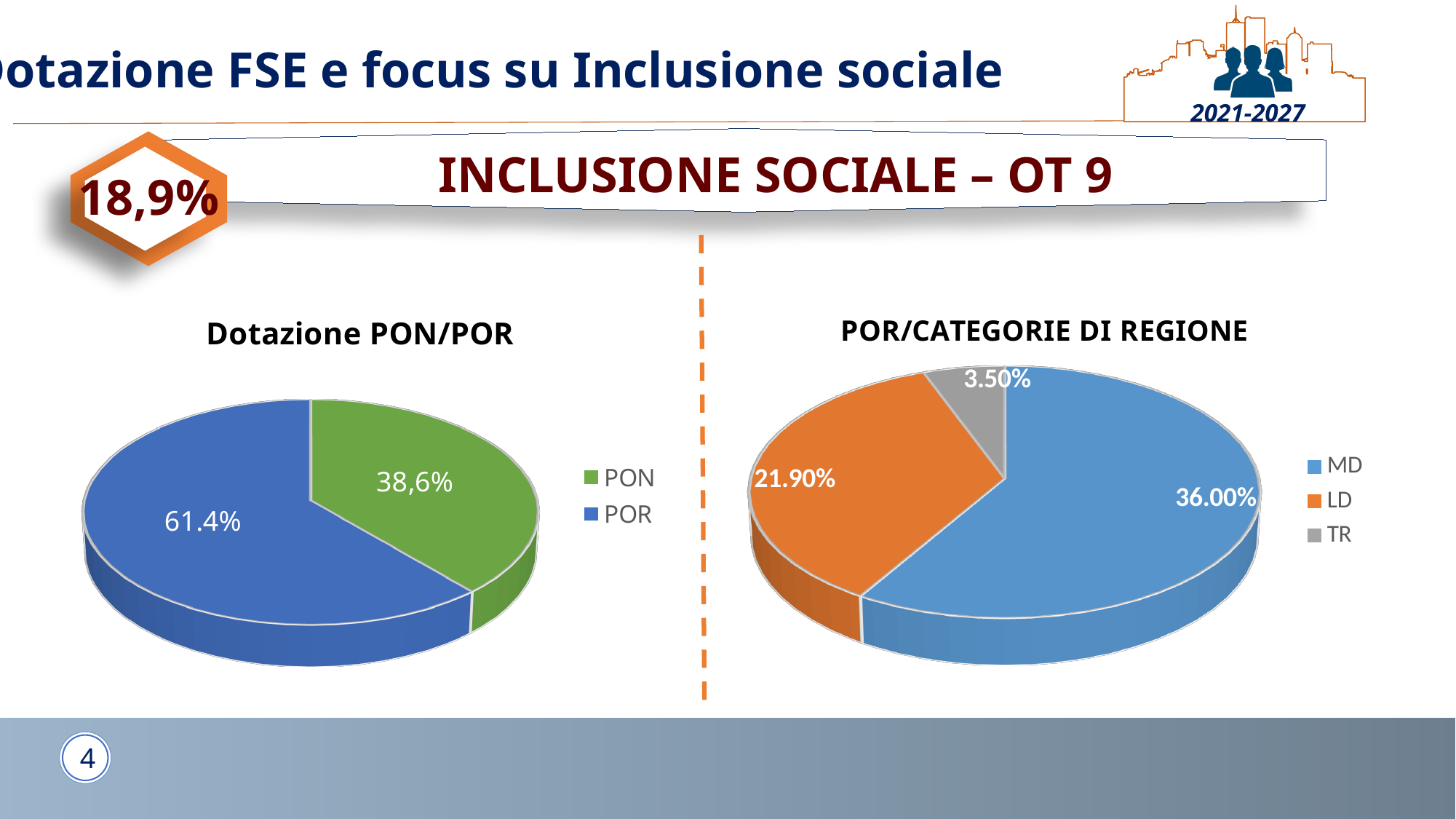
In the 'POR/CATEGORIE DI REGIONE' chart, which category has the smallest slice? TR In the 'POR/CATEGORIE DI REGIONE' chart, what is the value shown for LD? 21.90% In the 'POR/CATEGORIE DI REGIONE' chart, what is the value shown for TR? 3.50% How many entries does the legend of the 'Dotazione PON/POR' chart list? 2 What kind of chart is the 'Dotazione PON/POR' chart? pie chart In the 'Dotazione PON/POR' chart, which slice is larger, PON or POR? POR In the 'POR/CATEGORIE DI REGIONE' chart, which category has the largest slice? MD In the 'POR/CATEGORIE DI REGIONE' chart, what is the value shown for MD? 36.00% In the 'Dotazione PON/POR' chart, what is the value shown for POR? 61.4% In the 'Dotazione PON/POR' chart, what is the value shown for PON? 38,6% In the 'POR/CATEGORIE DI REGIONE' chart, what is the difference between the MD and LD values? 14.10% How many slices does the 'POR/CATEGORIE DI REGIONE' pie chart have? 3